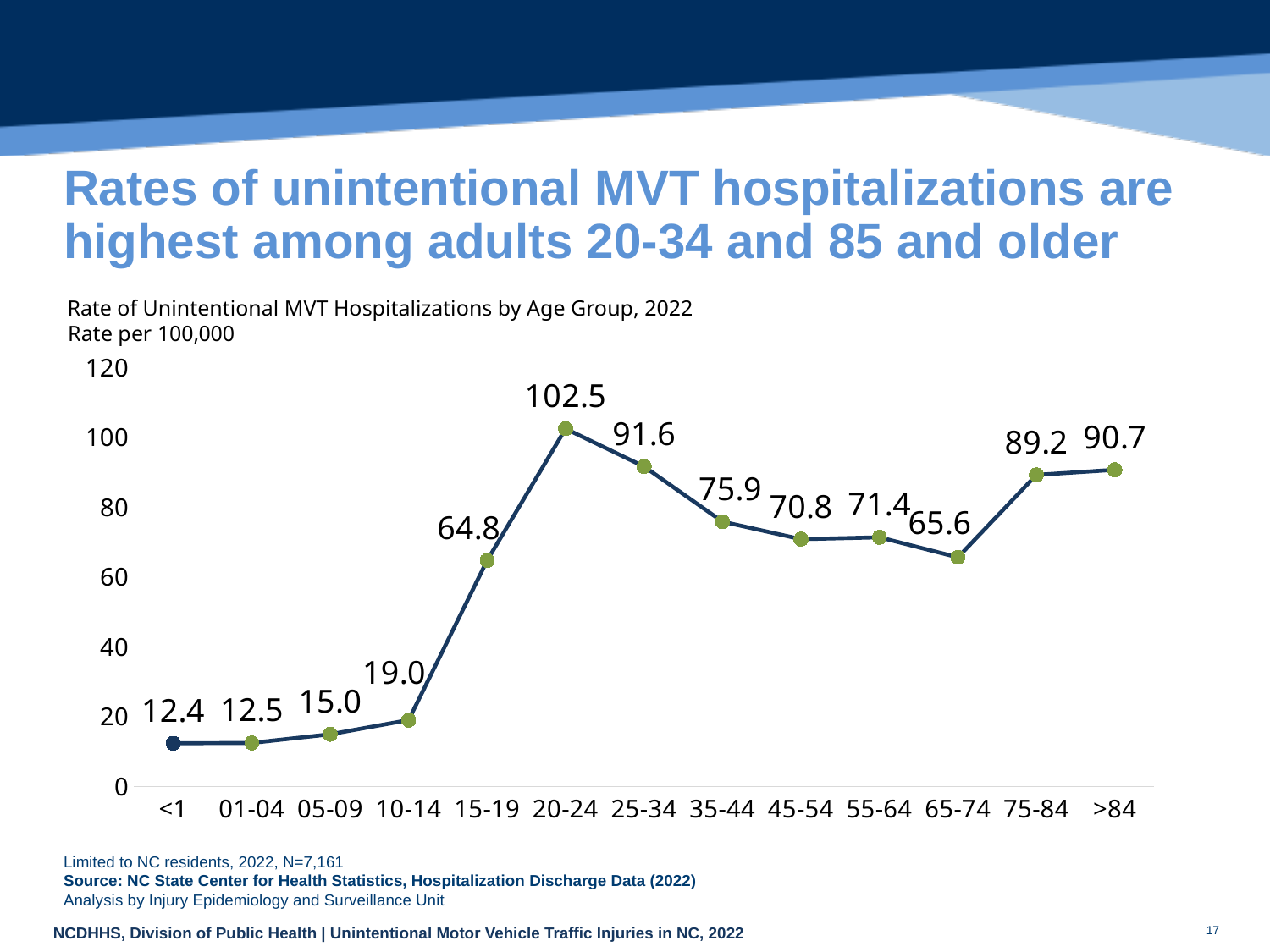
What is the difference between the rates for the 20-24 and 25-34 age groups? 10.9 Which age group has a higher rate, 75-84 or >84? >84 Which age group has the highest rate of unintentional MVT hospitalizations? 20-24 What kind of chart is shown on the slide? Line chart What is the title of the chart? Rate of Unintentional MVT Hospitalizations by Age Group, 2022 Do the rates rise or fall from the 20-24 age group to the 65-74 age group? Fall What is the rate of unintentional MVT hospitalizations for the 20-24 age group? 102.5 How many age groups are plotted on the chart? 13 What is the rate for the >84 age group? 90.7 What is the rate for the 15-19 age group? 64.8 Is the rate for the 65-74 age group greater or less than 60? greater Which age group has the lowest rate of unintentional MVT hospitalizations? <1